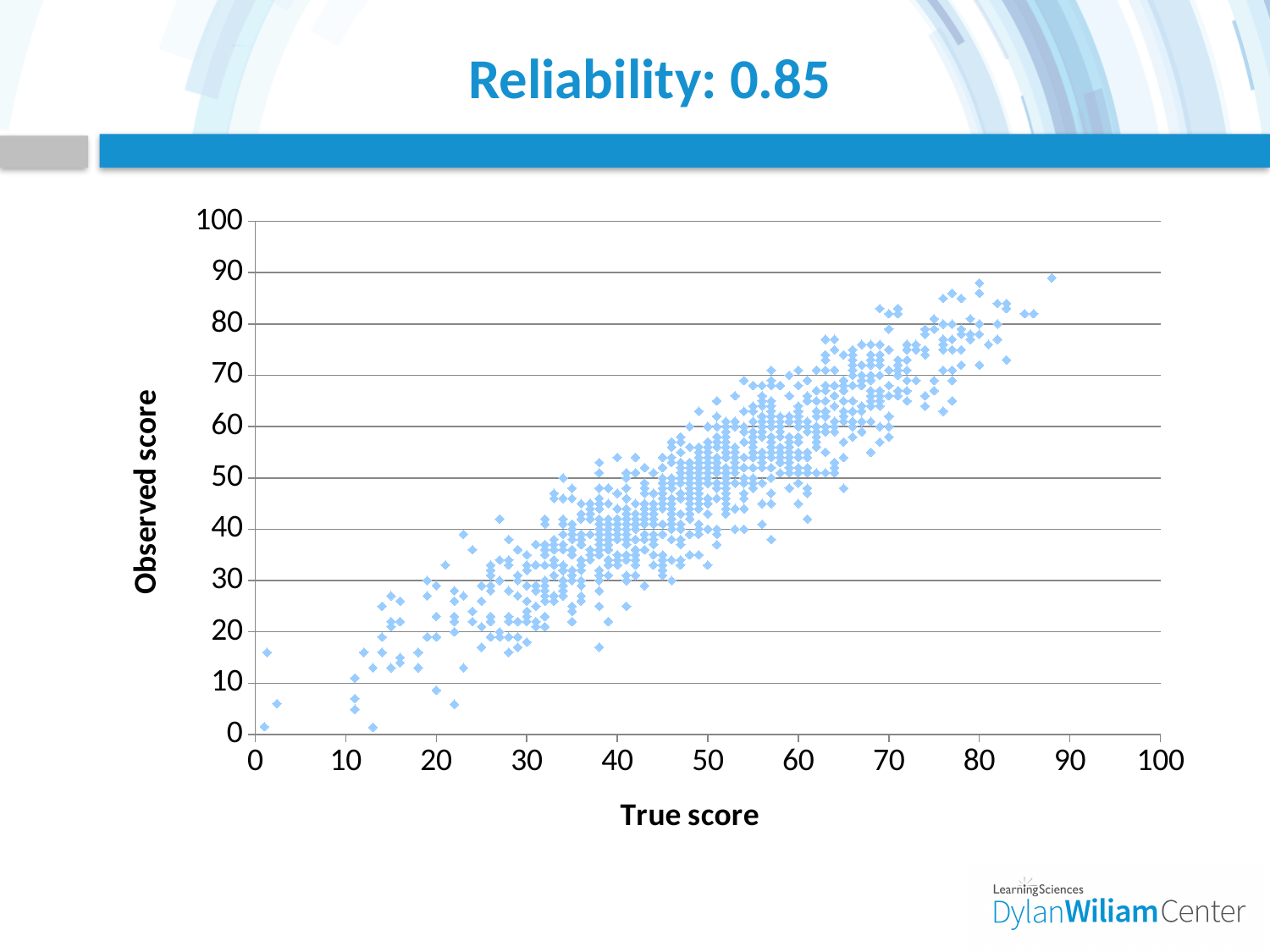
What kind of chart is shown on the slide? scatter plot What is the title of the chart? Reliability: 0.85 What is the label of the vertical axis? Observed score Is the highest true score plotted greater or less than 90? less Do the observed scores generally rise or fall as the true score increases along the x axis? rise Is the lowest observed score plotted greater or less than 10? less Is the highest observed score plotted greater or less than 80? greater